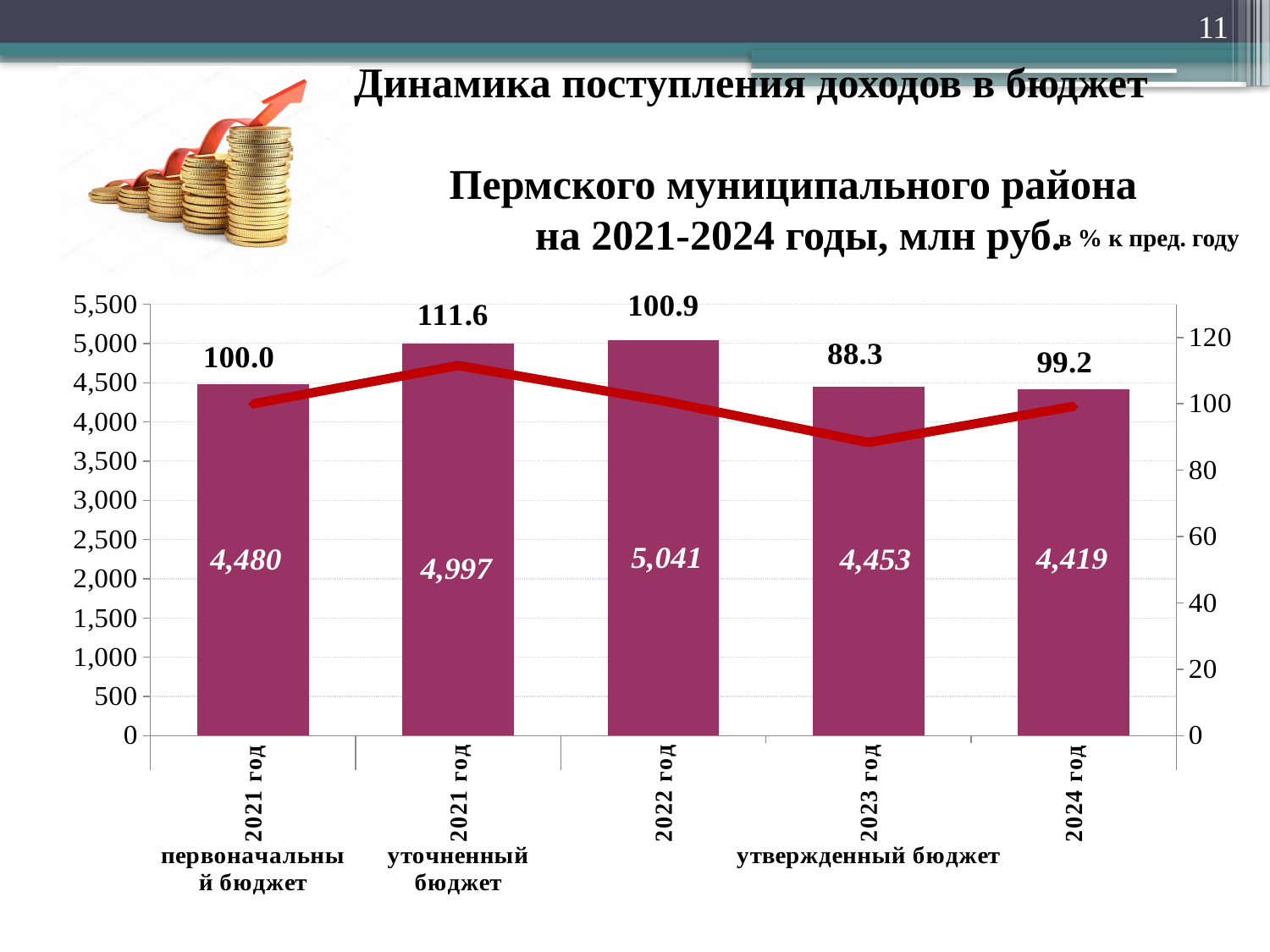
What is the bar value for 2022 год? 5,041 How many bars are plotted in the chart? 5 What colour is the line series in the chart? red What is the line value (в % к пред. году) for 2021 год (уточненный бюджет)? 111.6 What is the line value (в % к пред. году) for 2023 год? 88.3 What is the bar value for 2021 год (уточненный бюджет)? 4,997 Which is larger, the bar value for 2021 год (первоначальный бюджет) or for 2023 год? 2021 год (первоначальный бюджет) Do the bar values rise or fall from 2022 год to 2024 год? fall Which category has the highest bar value? 2022 год What is the bar value for 2024 год? 4,419 Which category has the lowest bar value? 2024 год What is the difference between the bar values for 2022 год and 2023 год? 588